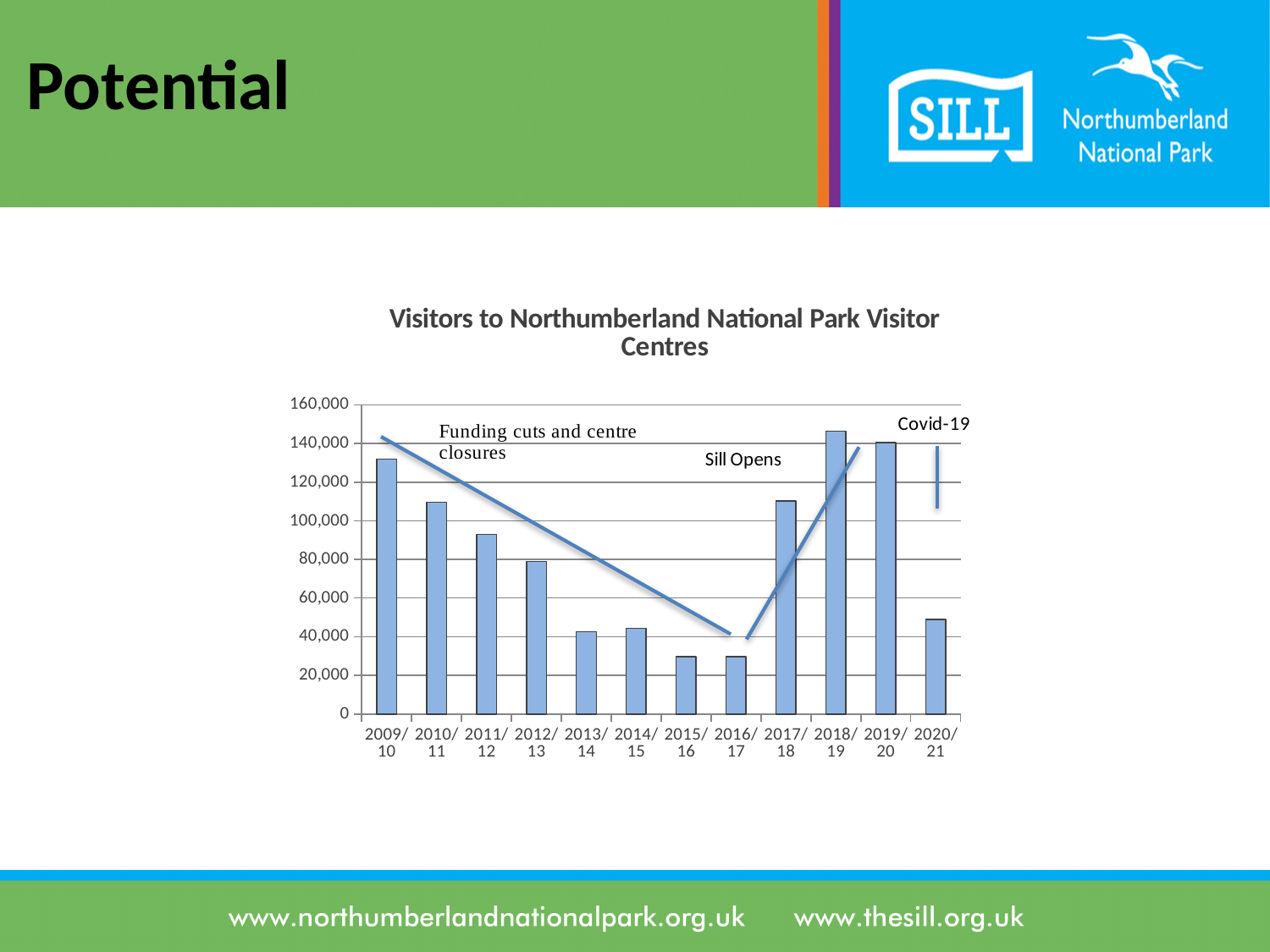
Which year has more visitors, 2010/11 or 2011/12? 2010/11 How many years (categories) are plotted on the x axis? 12 Is the value for 2015/16 greater or less than 40,000? less What event is annotated on the chart near the 2016/17 and 2017/18 bars? Sill Opens Which year has the highest number of visitors? 2018/19 Is the value for 2017/18 greater or less than 100,000? greater Is the value for 2009/10 greater or less than 120,000? greater Which year has more visitors, 2019/20 or 2020/21? 2019/20 What kind of chart is shown on the slide? bar chart Do visitor numbers rise or fall from 2009/10 to 2012/13? fall What is the title of the chart? Visitors to Northumberland National Park Visitor Centres